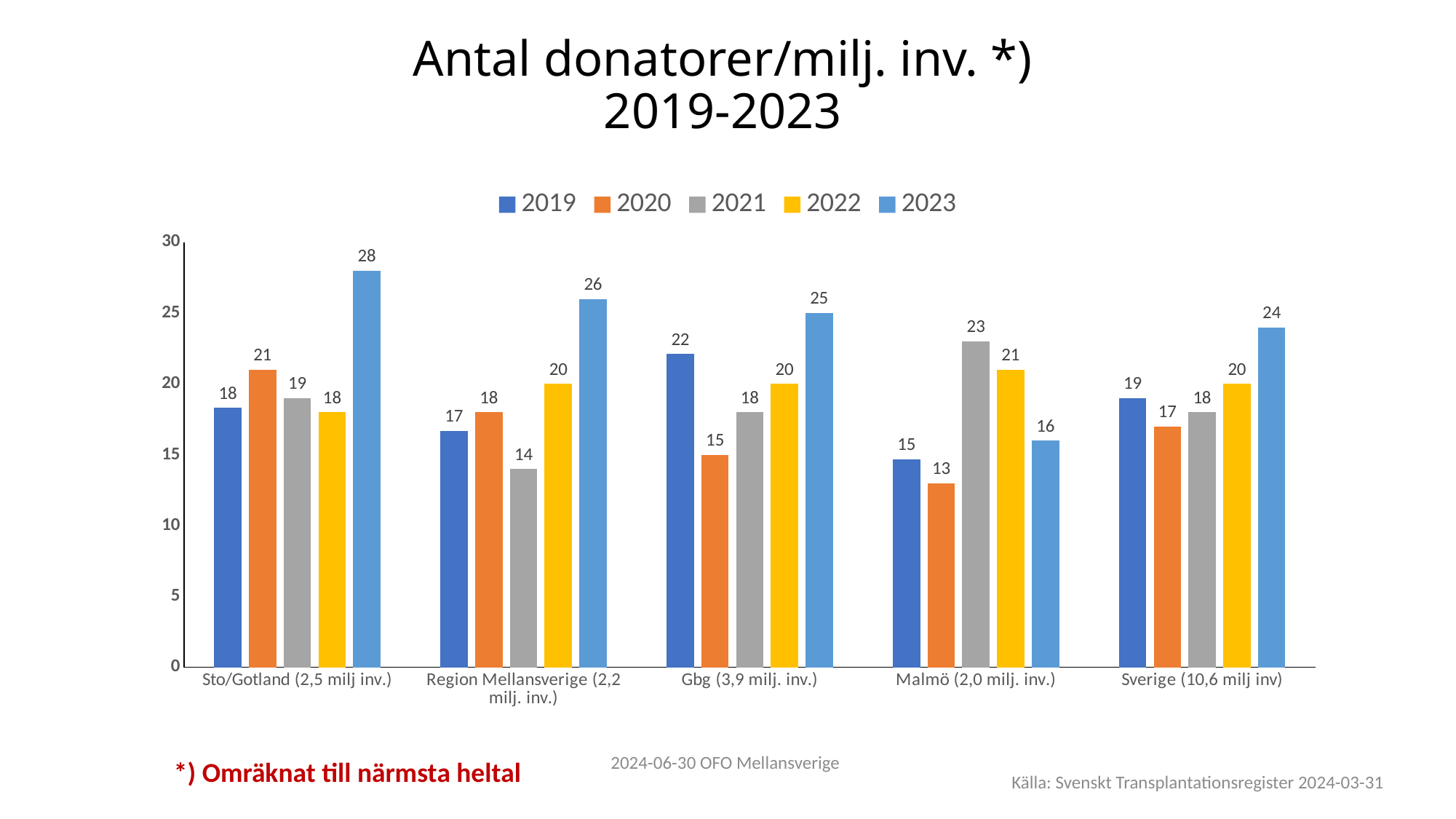
How many series does the legend list? 5 Is the value for Malmö (2,0 milj. inv.) in 2023 greater or less than 20? less Which region has the lowest value in 2020? Malmö (2,0 milj. inv.) What is the difference between the 2023 and 2019 values for Region Mellansverige (2,2 milj. inv.)? 9 What is the value for Sverige (10,6 milj inv) in 2020? 17 What is the title of the chart? Antal donatorer/milj. inv. *) 2019-2023 What is the value for Malmö (2,0 milj. inv.) in 2021? 23 What is the value for Sto/Gotland (2,5 milj inv.) in 2023? 28 Which is larger for Gbg (3,9 milj. inv.): the 2019 value or the 2020 value? 2019 What kind of chart is shown on the slide? bar chart Which region has the highest value in 2023? Sto/Gotland (2,5 milj inv.) How many regions are shown on the x axis? 5